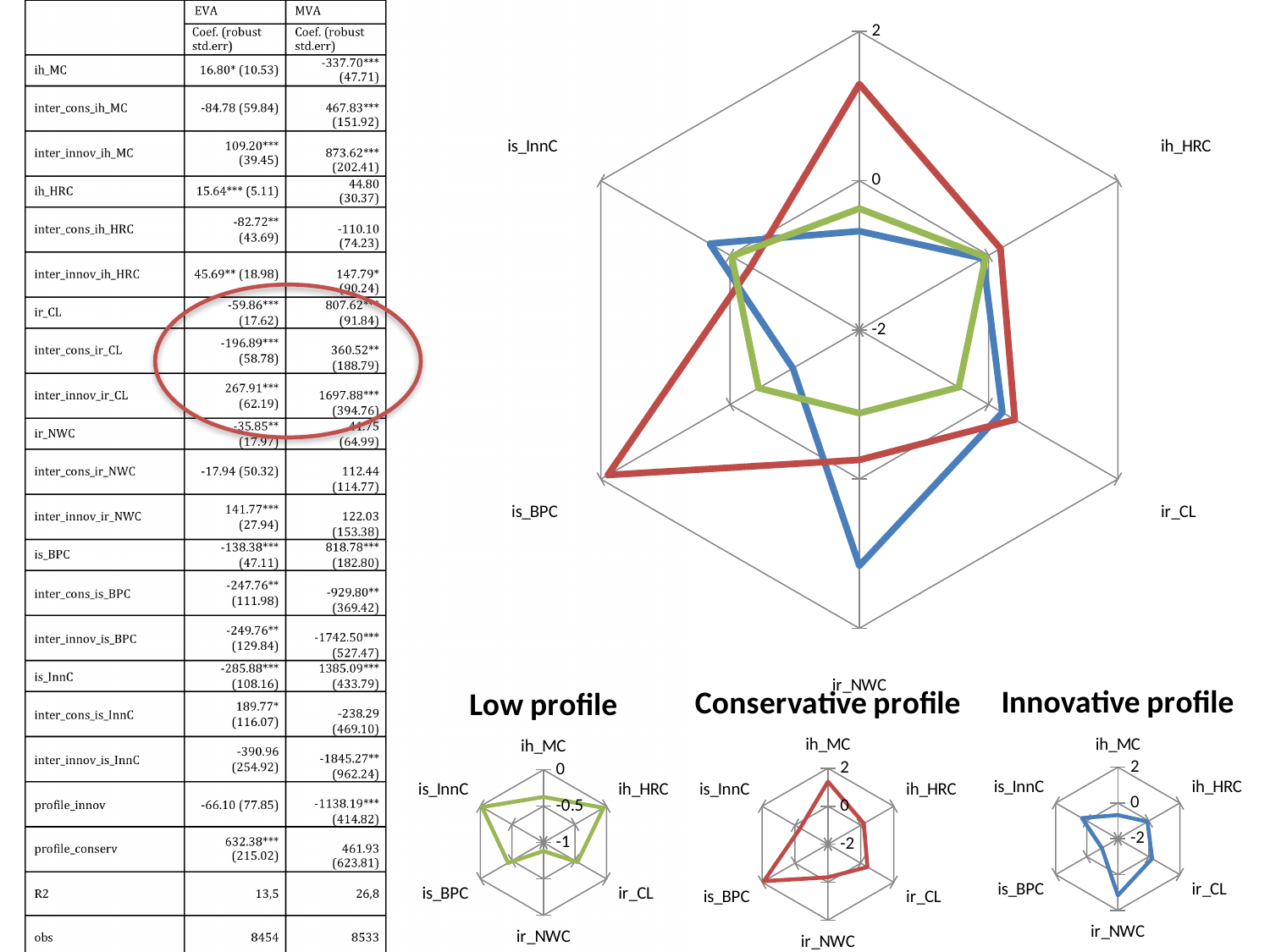
On the large radar chart, is the value of the blue series for is_BPC greater or less than 0? less How many data series are plotted on the large radar chart? 3 What kind of chart is the large chart on the right side of the slide? radar chart On the large radar chart, on which axis does the blue series reach its highest value? ir_NWC On the large radar chart, is the value of the green series for ir_NWC greater or less than 0? less On the Conservative profile chart, is the value for is_BPC greater or less than 0? greater What are the titles of the three small radar charts at the bottom of the slide? Low profile, Conservative profile, Innovative profile On the large radar chart, on which axis does the red series reach its highest value? is_BPC How many axes (categories) does the large radar chart have? 6